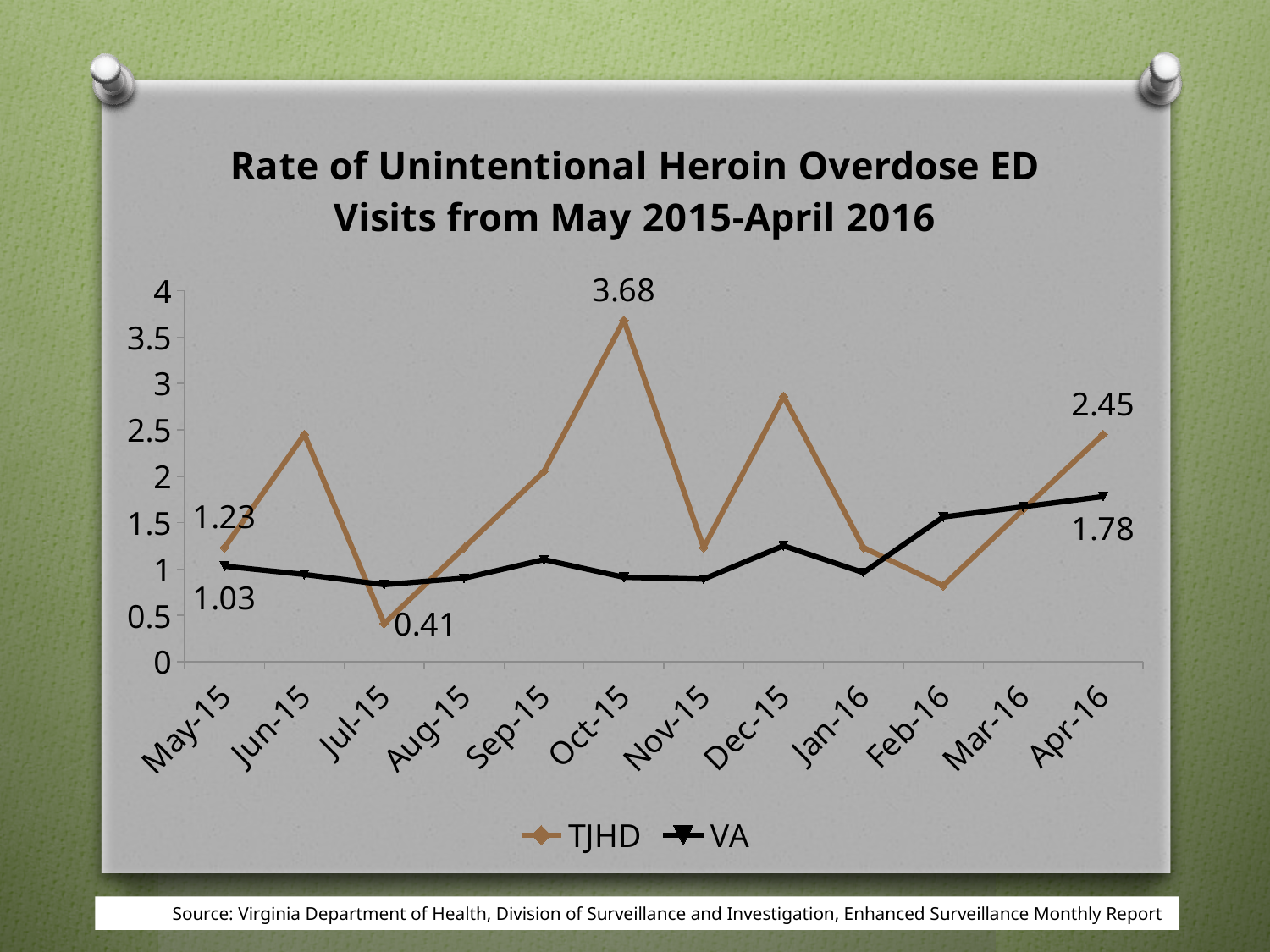
What kind of chart is shown on the slide? Line chart Which series has the larger value in Oct-15, TJHD or VA? TJHD What is the difference between the TJHD and VA values for Apr-16? 0.67 How many months are shown on the x axis? 12 What is the VA value for Apr-16? 1.78 What is the VA value for May-15? 1.03 In which month does the TJHD series reach its lowest value? Jul-15 What is the difference between the TJHD values for Oct-15 and Jul-15? 3.27 What is the TJHD value for Oct-15? 3.68 Is the TJHD value for Dec-15 greater or less than 2.5? greater In which month does the TJHD series reach its highest value? Oct-15 What is the TJHD value for Jul-15? 0.41